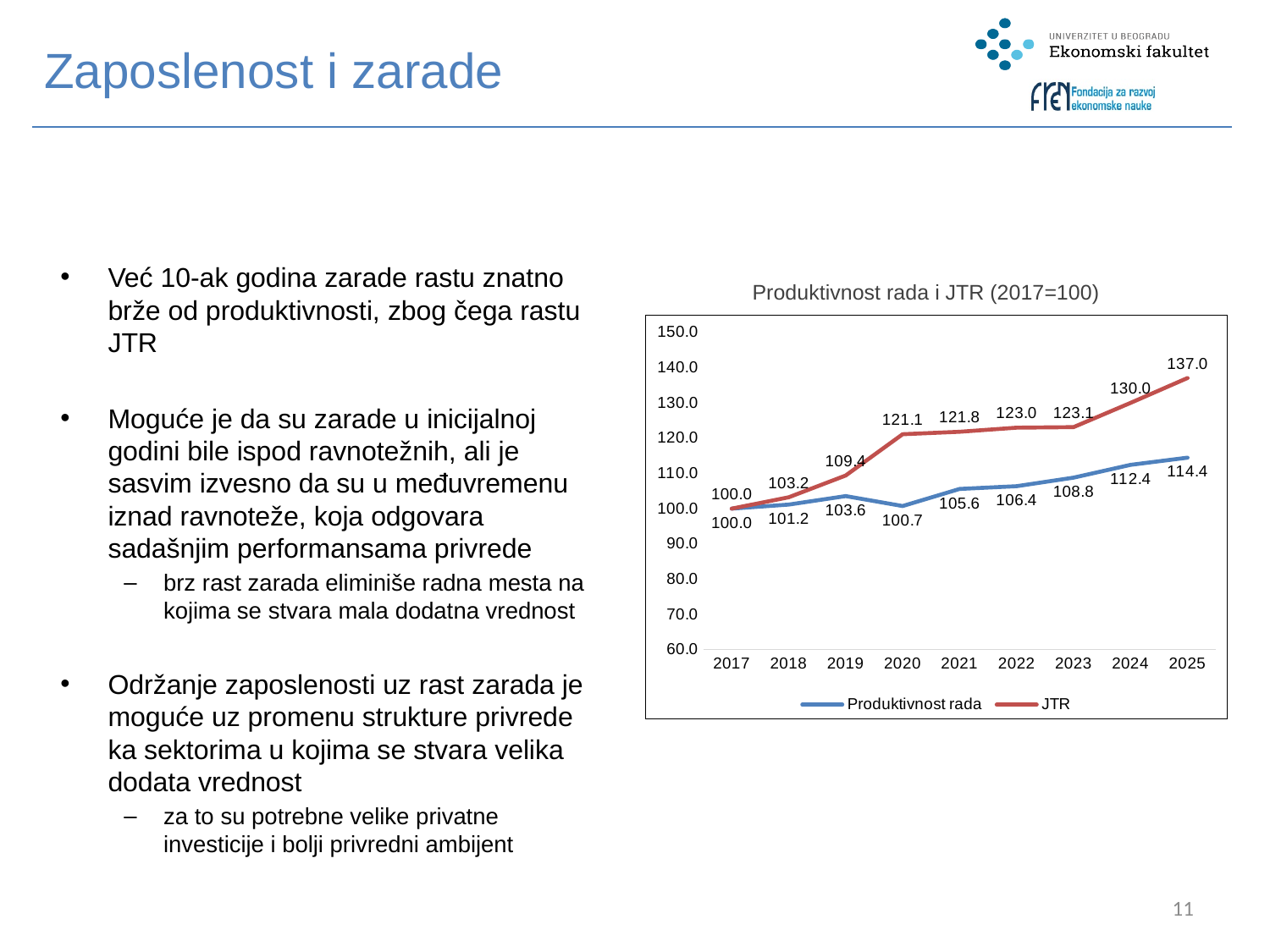
In which year is JTR lowest? 2017 What type of chart is shown on the slide? line chart What is the value of JTR in 2019? 109.4 In which year is Produktivnost rada highest? 2025 What is the value of JTR in 2025? 137.0 How many series does the chart legend list? 2 What is the difference between JTR and Produktivnost rada in 2025? 22.6 What is the title of the chart? Produktivnost rada i JTR (2017=100) How many years are shown on the x axis of the chart? 9 Does JTR generally rise or fall from 2017 to 2025? rise Which series has the larger value in 2023, Produktivnost rada or JTR? JTR What is the value of Produktivnost rada in 2020? 100.7